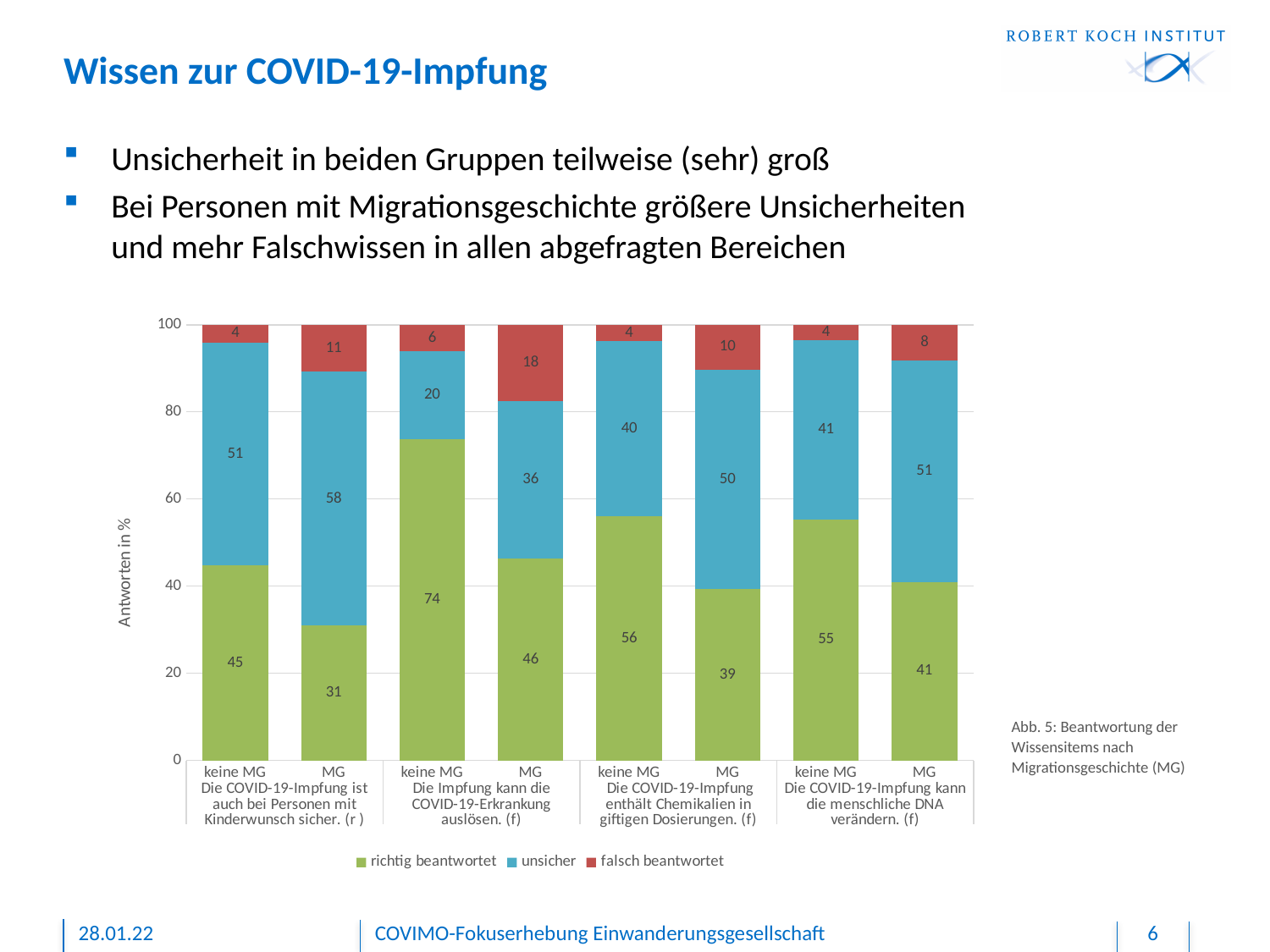
How many series does the legend list? 3 Which bar has the highest 'richtig beantwortet' value? keine MG, Die Impfung kann die COVID-19-Erkrankung auslösen How many bars are plotted in the chart? 8 What is the 'unsicher' value for 'MG' on the item 'Die COVID-19-Impfung ist auch bei Personen mit Kinderwunsch sicher'? 58 What is the difference between the 'richtig beantwortet' values for 'keine MG' and 'MG' on the item 'Die COVID-19-Impfung kann die menschliche DNA verändern'? 14 What kind of chart is shown on the slide? stacked bar chart What is the label of the y axis? Antworten in % What is the total of the stacked bar for 'keine MG' on the item 'Die COVID-19-Impfung enthält Chemikalien in giftigen Dosierungen'? 100 Which bar has the lowest 'richtig beantwortet' value? MG, Die COVID-19-Impfung ist auch bei Personen mit Kinderwunsch sicher Which is larger: the 'unsicher' value for 'MG' on the Chemikalien item or the 'unsicher' value for 'keine MG' on the same item? MG What is the 'falsch beantwortet' value for 'MG' on the item 'Die Impfung kann die COVID-19-Erkrankung auslösen'? 18 What is the 'richtig beantwortet' value for 'keine MG' on the item 'Die Impfung kann die COVID-19-Erkrankung auslösen'? 74